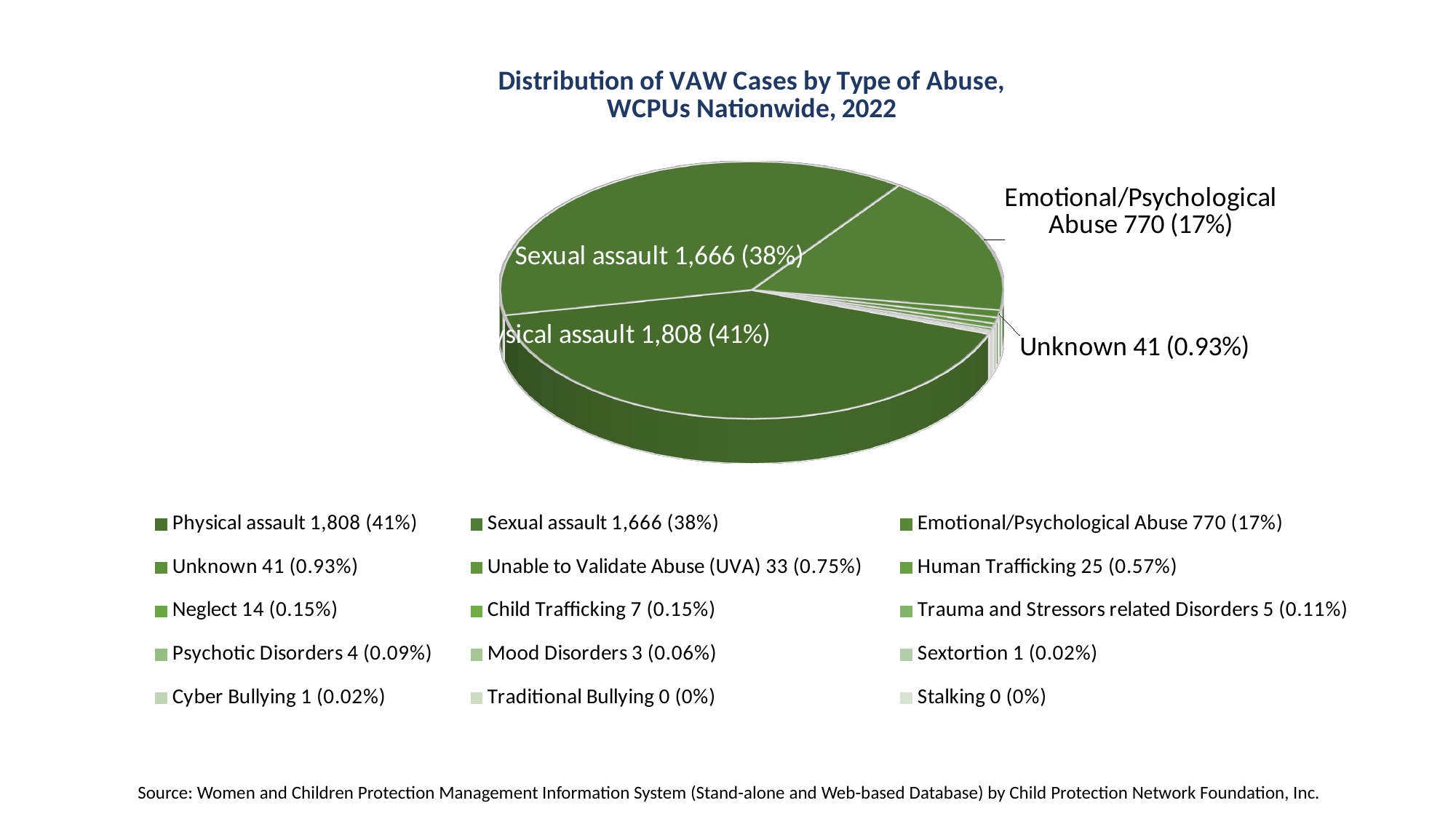
Which has more cases, Unknown or Unable to Validate Abuse (UVA)? Unknown How many categories does the legend list? 15 Which type of abuse has the highest number of cases? Physical assault How many cases of Physical assault are shown? 1,808 What is the difference in cases between Physical assault and Sexual assault? 142 How many cases are listed for Human Trafficking? 25 How many cases of Emotional/Psychological Abuse are shown? 770 What is the title of the chart? Distribution of VAW Cases by Type of Abuse, WCPUs Nationwide, 2022 What share of the pie does Sexual assault represent? 38% What percentage is shown for Neglect? 0.15% What is the difference in cases between Sexual assault and Emotional/Psychological Abuse? 896 What kind of chart is shown on the slide? Pie chart